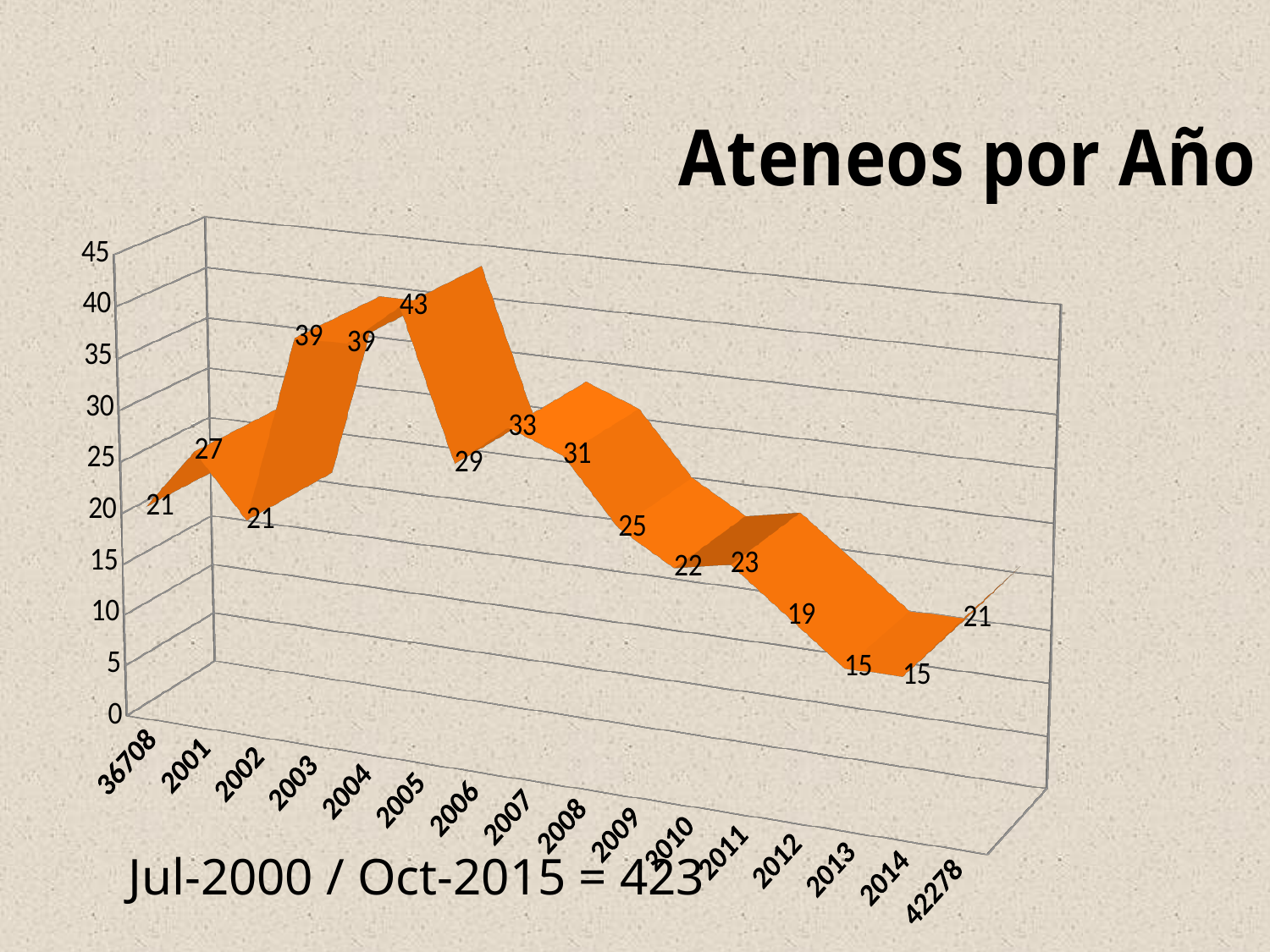
Do the values rise or fall from 2008 to 2013? fall Which year has the highest value? 2005 Which is larger, the value for 2003 or the value for 2006? 2003 What is the value for 2012? 19 What is the title of the chart? Ateneos por Año What is the value for 2005? 43 What kind of chart is this? 3D line chart What is the difference between the values for 2001 and 2002? 6 What is the lowest value plotted on the chart? 15 What is the value for 2007? 33 What is the difference between the values for 2005 and 2013? 28 How many categories are shown on the x axis? 16